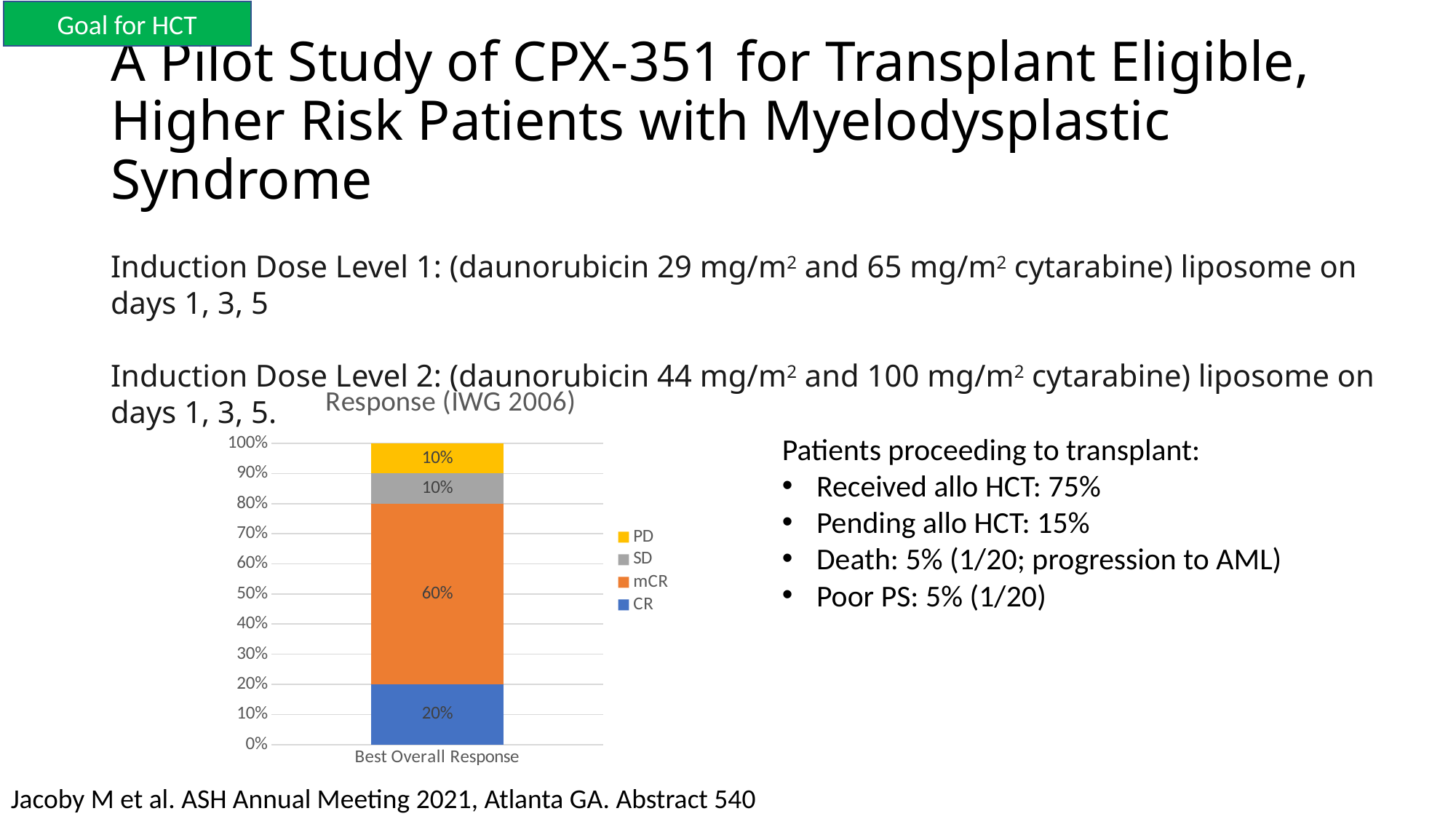
What is the title of the chart? Response (IWG 2006) What is the value of the CR segment in the Best Overall Response bar? 20% How many categories are shown on the x axis of the chart? 1 Which is larger in the chart, the CR value or the SD value? CR What is the value of the PD segment in the Best Overall Response bar? 10% How many series does the chart legend list? 4 What kind of chart is shown on the slide? Stacked bar chart What is the total of the stacked Best Overall Response bar? 100% What is the difference between the mCR and CR values in the chart? 40% What is the value of the SD segment in the Best Overall Response bar? 10% Which response category has the largest share of the Best Overall Response bar? mCR What is the value of the mCR segment in the Best Overall Response bar? 60%